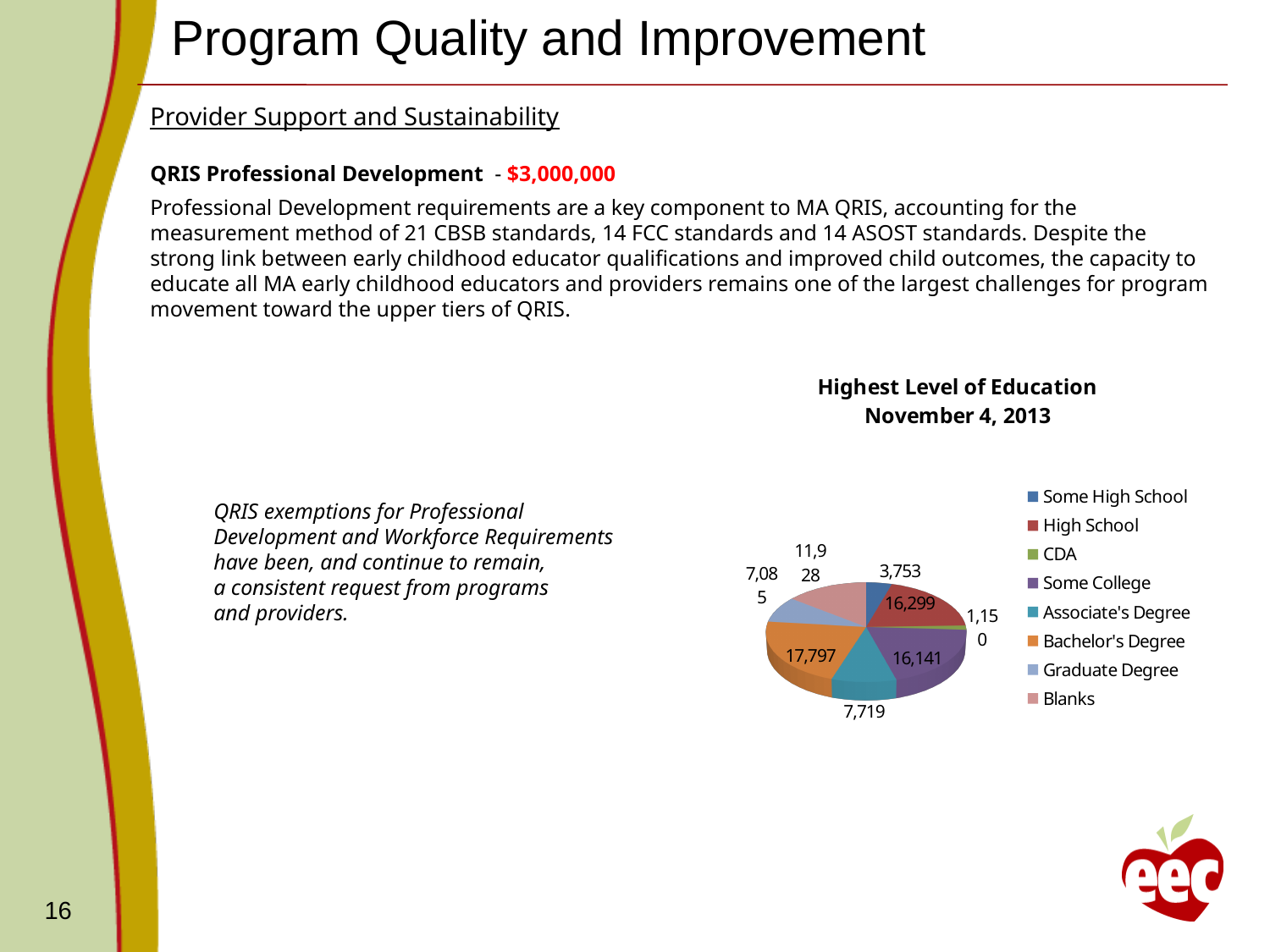
What is the value for Some College? 16,141 What is the value for Associate's Degree? 7,719 Which category has the smallest slice of the pie? CDA What type of chart is shown on the slide? pie chart Which is larger, the value for High School or the value for Some College? High School What is the title of the chart? Highest Level of Education November 4, 2013 What is the difference between the Bachelor's Degree value and the High School value? 1,498 Which category has the largest slice of the pie? Bachelor's Degree How many categories does the pie chart legend list? 8 What is the value for Some High School? 3,753 What is the value for High School? 16,299 What is the value for Bachelor's Degree? 17,797